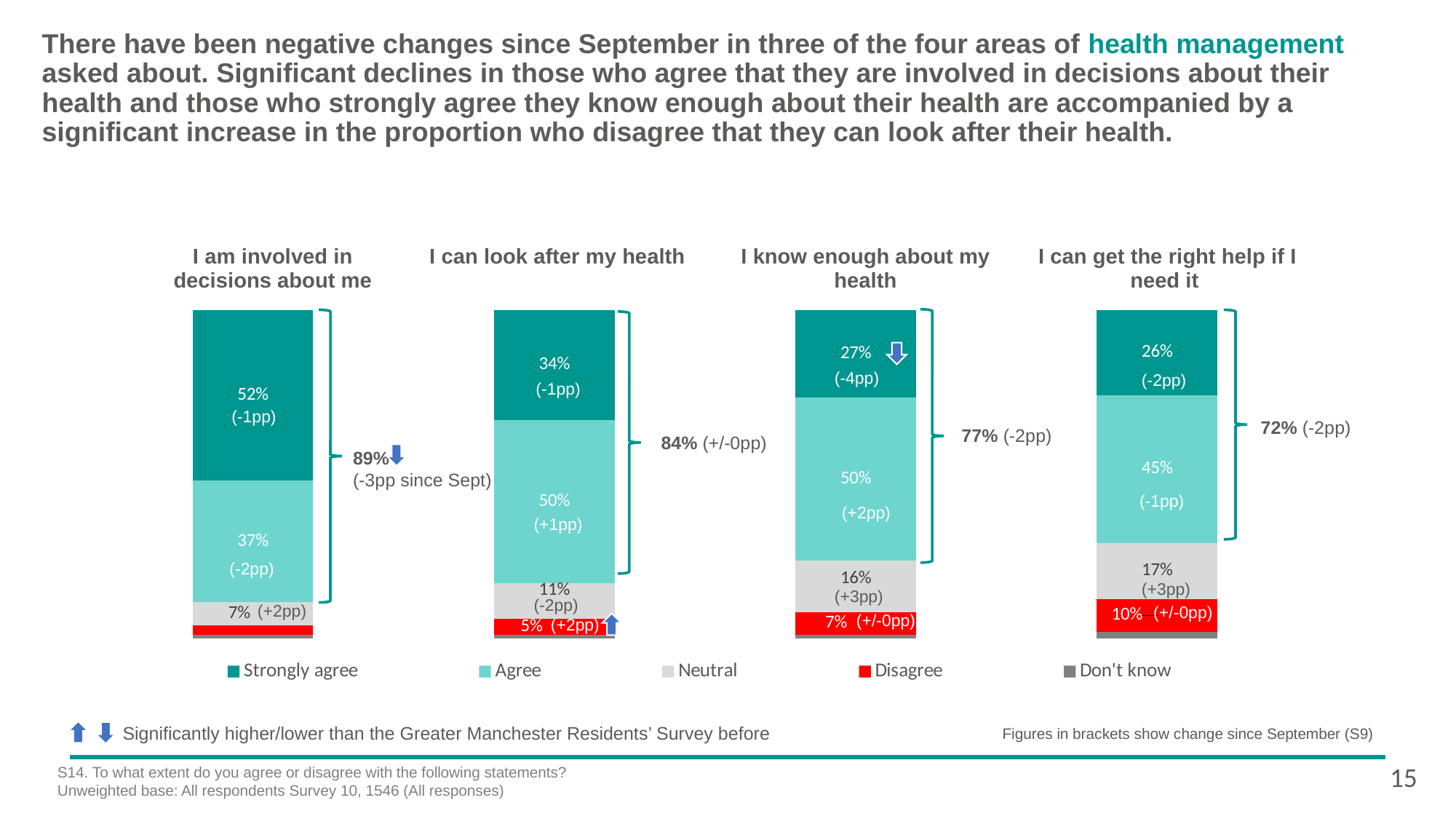
In the chart 'I am involved in decisions about me', what is the difference between the strongly agree and agree percentages? 15 percentage points In the chart 'I am involved in decisions about me', what percentage strongly agree? 52% In the chart 'I can look after my health', what is the change since September shown for the agree segment? +1pp Which statement has the lowest combined agree/strongly agree percentage? I can get the right help if I need it Which statement has the highest percentage who strongly agree? I am involved in decisions about me In the chart 'I can get the right help if I need it', what is the combined percentage who agree or strongly agree? 72% How many response categories does the legend list? 5 In the chart 'I can look after my health', what percentage disagree? 5% In the chart 'I know enough about my health', what percentage are neutral? 16% Is the neutral percentage larger for 'I know enough about my health' or for 'I can get the right help if I need it'? I can get the right help if I need it How many statements are shown as stacked bars on the slide? 4 What type of chart is used on the slide? Stacked bar chart